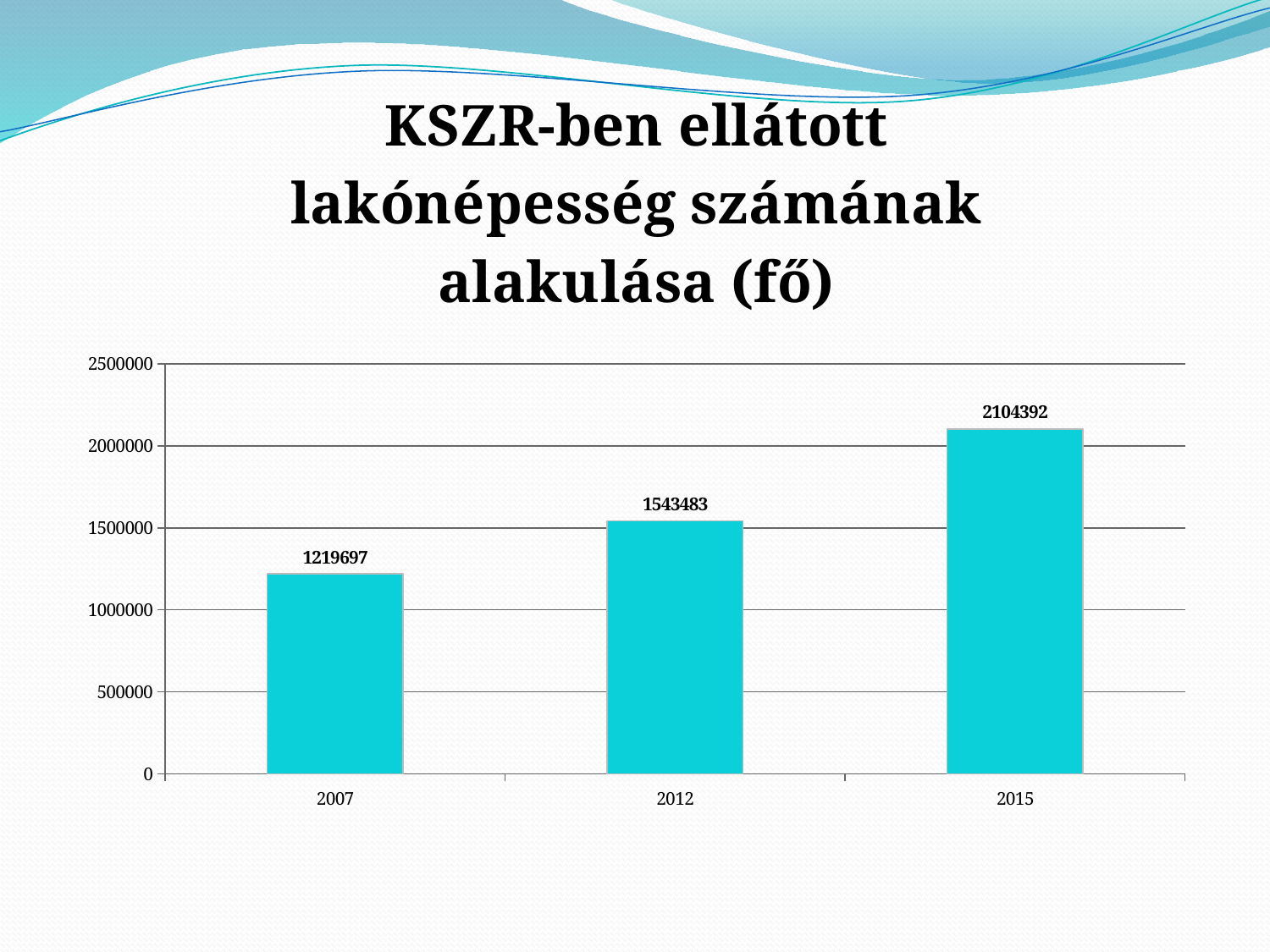
What is the value for 2015? 2104392 Which year has the highest value? 2015 What is the value for 2012? 1543483 How many years are shown on the x axis? 3 Which is larger, the value for 2012 or the value for 2015? 2015 What is the difference between the values for 2015 and 2007? 884695 Is the value for 2015 greater or less than 2000000? greater What is the value for 2007? 1219697 What is the difference between the values for 2012 and 2007? 323786 What kind of chart is shown on the slide? bar chart Which year has the lowest value? 2007 Do the values rise or fall from 2007 to 2015? rise